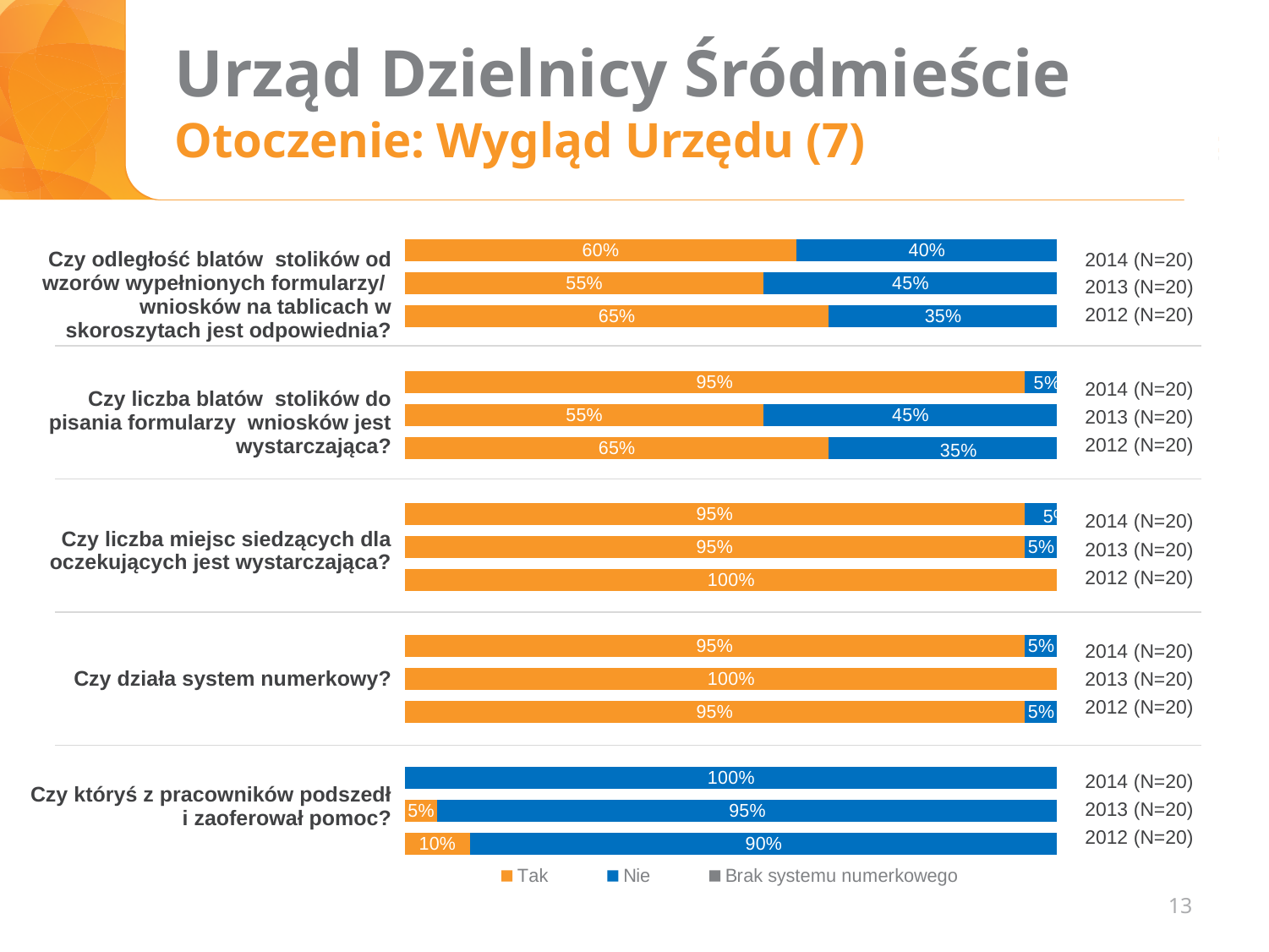
In the chart for "Czy liczba miejsc siedzących dla oczekujących jest wystarczająca?", what is the Tak value for 2012 (N=20)? 100% What type of chart is used for "Czy działa system numerkowy?"? Stacked bar chart In the chart for "Czy liczba blatów stolików do pisania formularzy wniosków jest wystarczająca?", what is the difference between the Tak values for 2014 (N=20) and 2013 (N=20)? 40% In the chart for "Czy któryś z pracowników podszedł i zaoferował pomoc?", which is larger: the Tak value for 2012 (N=20) or the Tak value for 2013 (N=20)? 2012 (N=20) In the chart for "Czy odległość blatów stolików od wzorów wypełnionych formularzy/wniosków na tablicach w skoroszytach jest odpowiednia?", what is the Tak value for 2014 (N=20)? 60% In the chart for "Czy działa system numerkowy?", which year has the lowest Tak value? 2014 (N=20) and 2012 (N=20) are tied at 95% In the chart for "Czy odległość blatów stolików od wzorów wypełnionych formularzy/wniosków na tablicach w skoroszytach jest odpowiednia?", what is the Nie value for 2012 (N=20)? 35% In the chart for "Czy odległość blatów stolików od wzorów wypełnionych formularzy/wniosków na tablicach w skoroszytach jest odpowiednia?", how many years (bars) are shown? 3 How many series does the legend at the bottom of the slide list? 3 In the chart for "Czy któryś z pracowników podszedł i zaoferował pomoc?", what is the Nie value for 2014 (N=20)? 100% In the chart for "Czy liczba blatów stolików do pisania formularzy wniosków jest wystarczająca?", which year has the highest Tak value? 2014 (N=20) In the chart for "Czy działa system numerkowy?", what is the Nie value for 2012 (N=20)? 5%